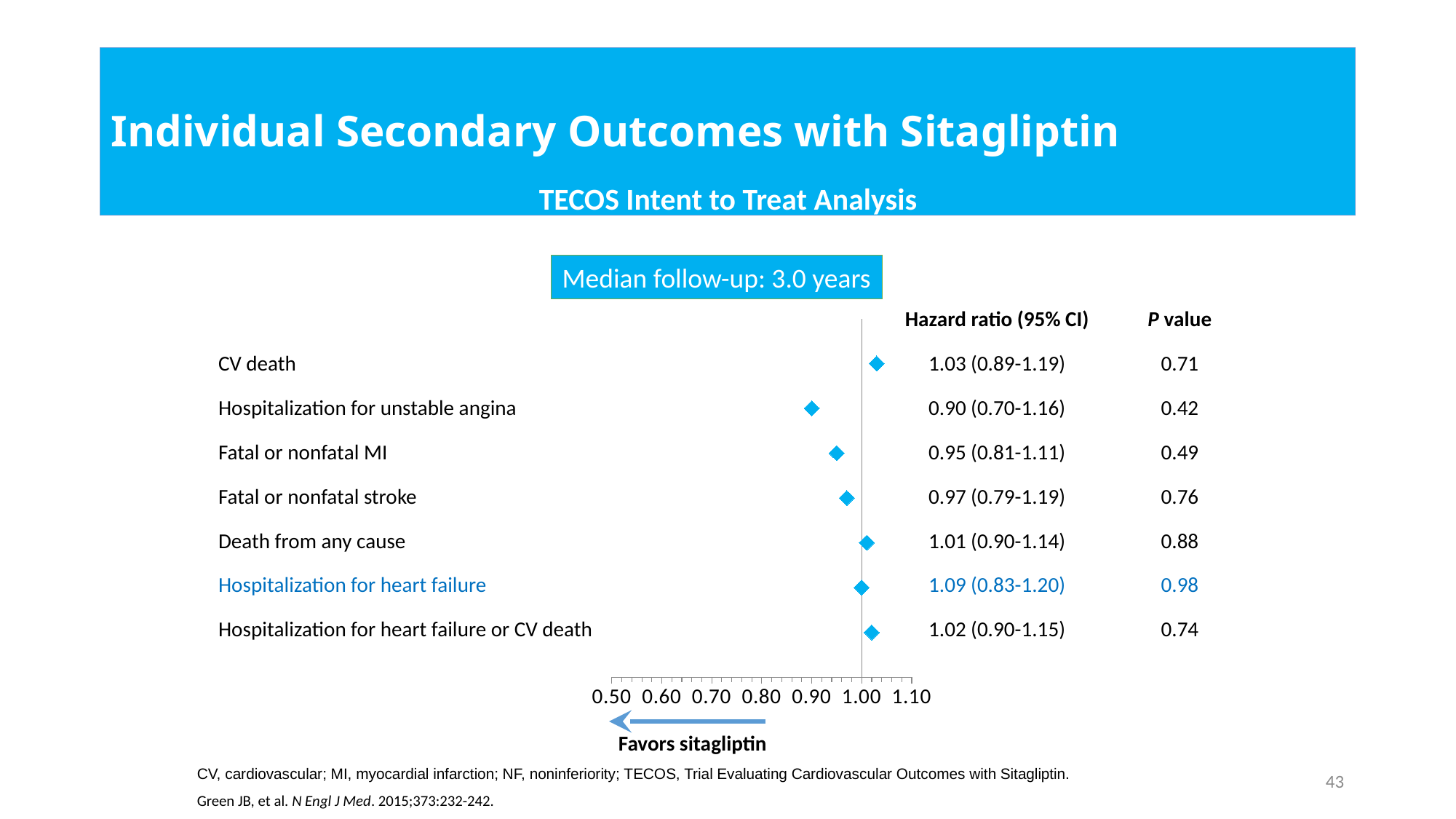
How many secondary outcomes are plotted on the chart? 7 What is the P value for hospitalization for unstable angina? 0.42 What is the median follow-up stated above the chart? 3.0 years What kind of chart is shown on the slide? Forest plot What is the hazard ratio for hospitalization for heart failure? 1.09 (0.83-1.20) What does the arrow below the x axis indicate? Favors sitagliptin Which outcome has the lowest hazard ratio? Hospitalization for unstable angina Which has the larger hazard ratio, fatal or nonfatal MI or fatal or nonfatal stroke? Fatal or nonfatal stroke Is the hazard ratio for hospitalization for unstable angina greater or less than 1.00? less What is the hazard ratio for CV death? 1.03 (0.89-1.19)